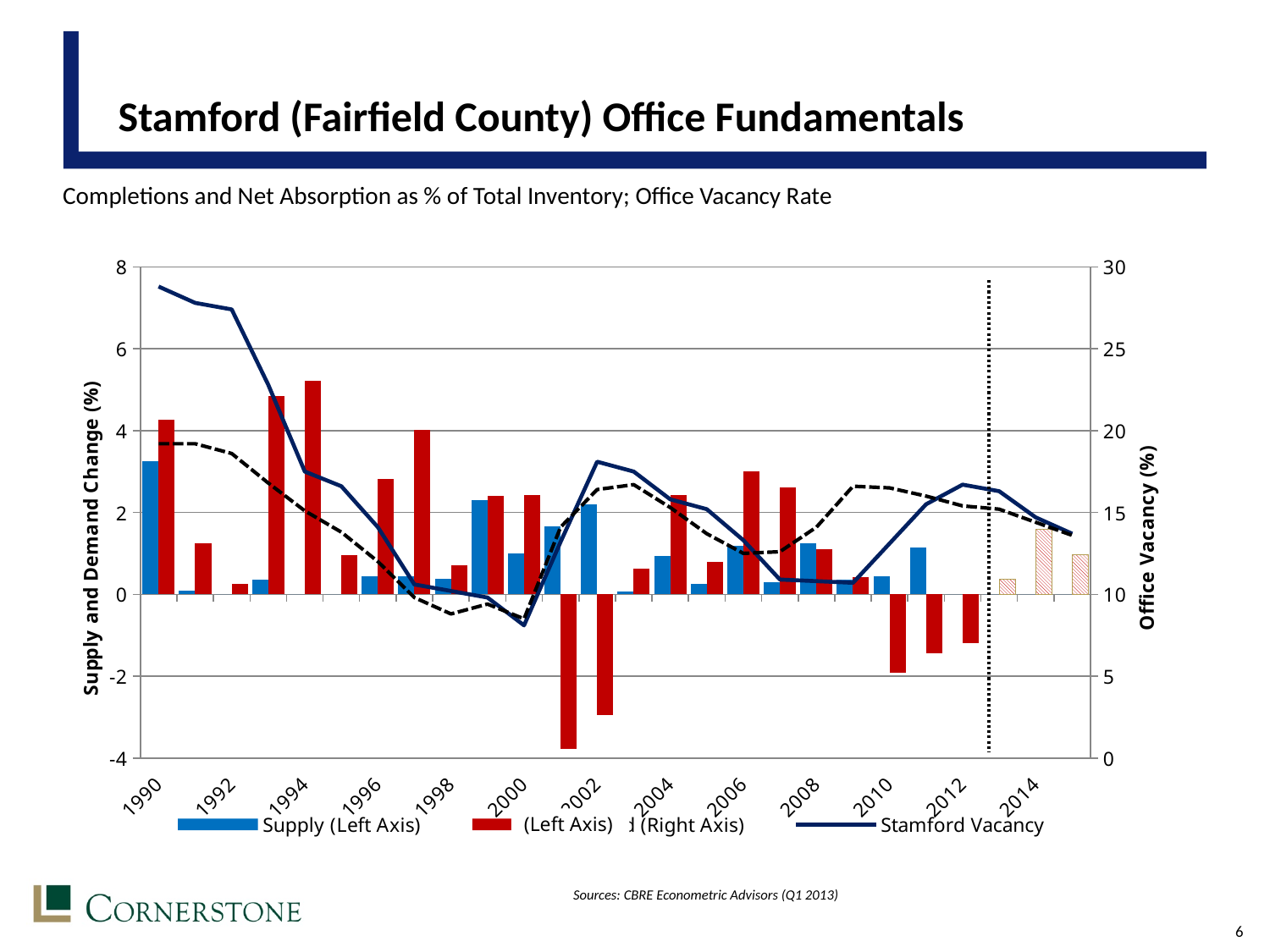
Is the Supply value for 1990 greater or less than 2? greater In which year is the red (Demand) bar the lowest? 2001 How many series does the legend list? 4 In which year is the blue Supply bar the highest? 1990 Is the Stamford Vacancy value for 1990 greater or less than 25 on the right axis? greater What is the label of the right-hand vertical axis? Office Vacancy (%) Does the Stamford Vacancy line rise or fall from 1990 to 1994? fall Is the red (Demand) bar for 2001 greater or less than -2? less Which is larger, the Supply bar for 1990 or the Supply bar for 2000? 1990 What is the title of the chart on the slide? Stamford (Fairfield County) Office Fundamentals What kind of chart is shown on the slide? Combined bar and line chart In which year is the red (Demand) bar the highest? 1994